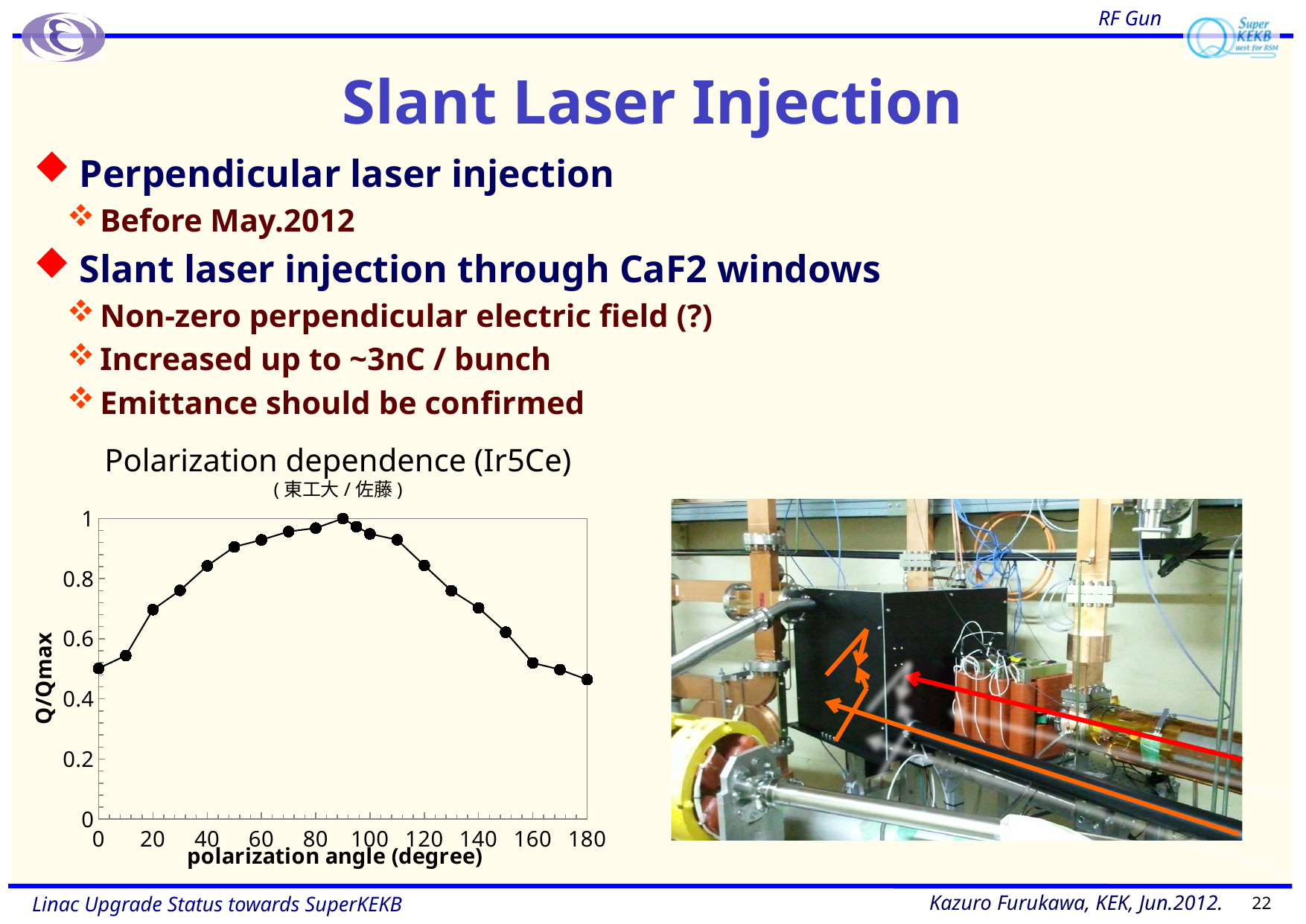
At which polarization angle is Q/Qmax highest? 90 How many data points are plotted on the chart? 20 Is the value of Q/Qmax at 0 degrees greater or less than 0.6? less Does Q/Qmax rise or fall as the polarization angle increases from 90 to 180 degrees? fall Is the value of Q/Qmax at 180 degrees greater or less than 0.6? less What is the title of the chart on the slide? Polarization dependence (Ir5Ce) Is the value of Q/Qmax at 60 degrees greater or less than 0.8? greater What is the label of the x axis of the chart? polarization angle (degree) What is the value of Q/Qmax at a polarization angle of 90 degrees? 1 What kind of chart is the 'Polarization dependence (Ir5Ce)' chart? line chart Which has a larger Q/Qmax value: 30 degrees or 150 degrees? 30 degrees